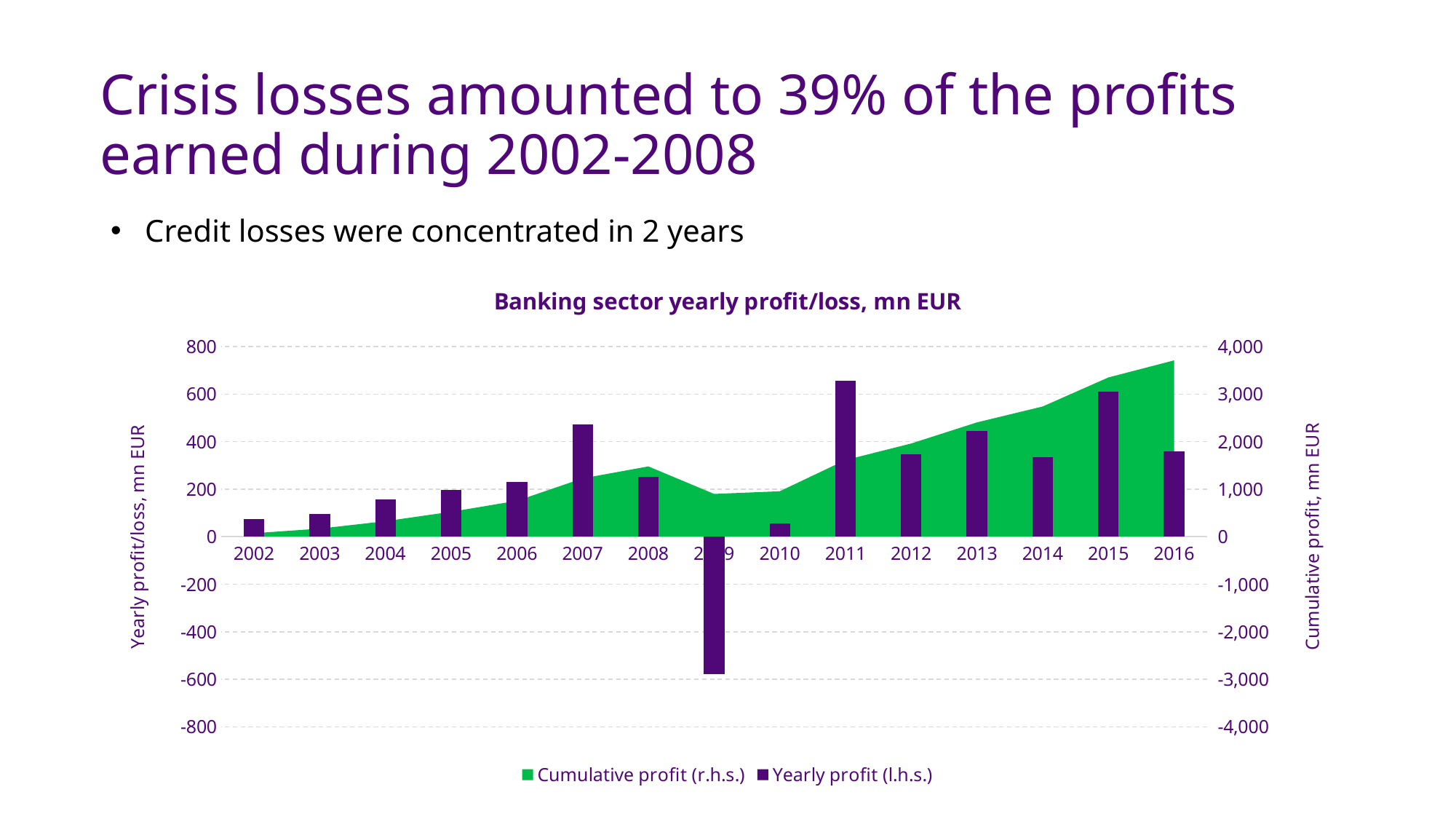
In which year was the yearly profit lowest? 2009 Is the yearly profit for 2007 greater or less than 400? greater Which year had the larger yearly profit, 2007 or 2008? 2007 Does the cumulative profit generally rise or fall from 2002 to 2016? Rise What is the title of the chart? Banking sector yearly profit/loss, mn EUR What kind of chart is used to show the yearly profit series? Bar chart Is the yearly profit for 2010 greater or less than 200? less How many series does the legend list? 2 Is the cumulative profit for 2016 greater or less than 3,000? greater In which year was the yearly profit highest? 2011 How many years are shown on the x axis? 15